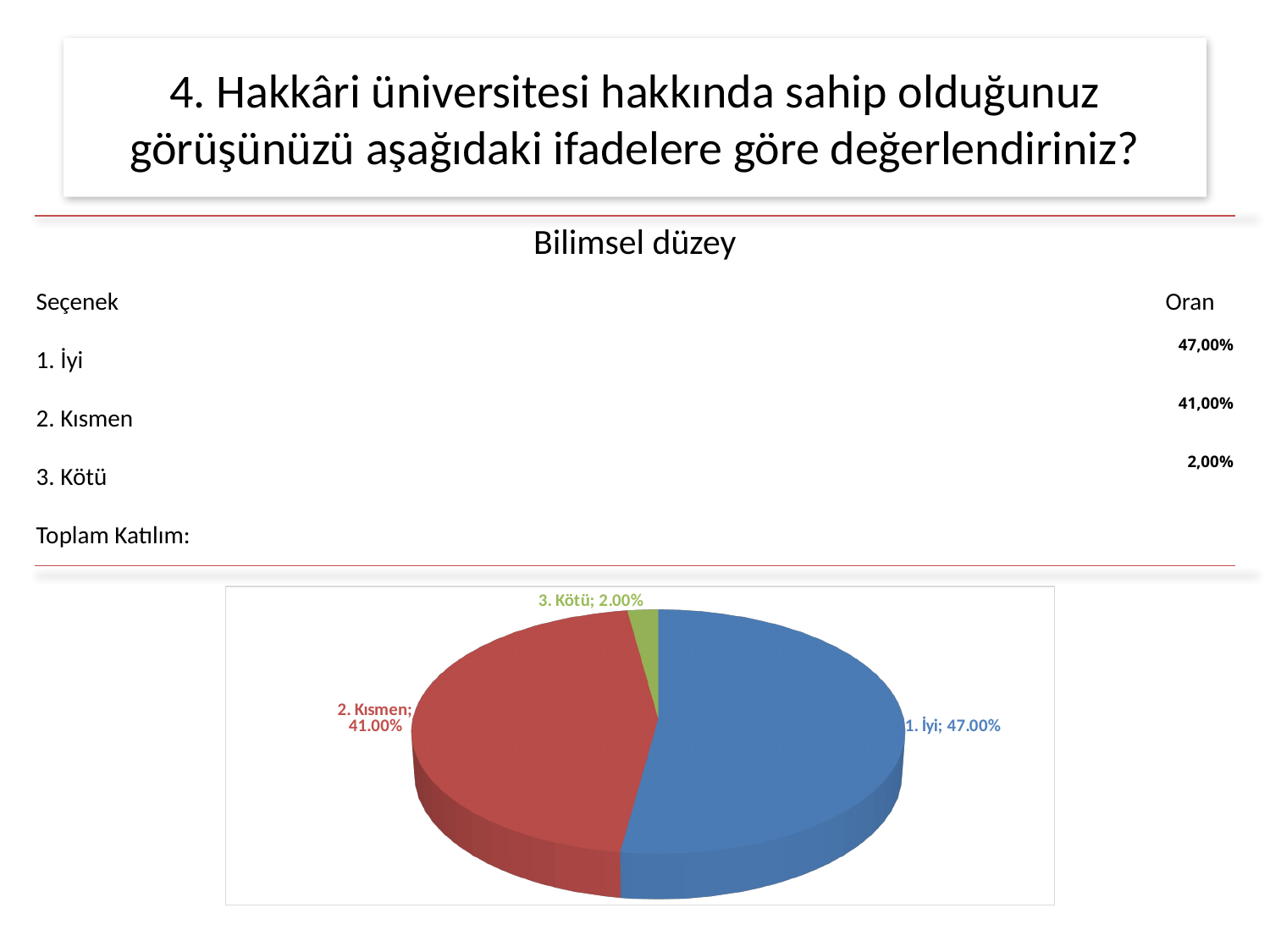
What is the value shown for the slice labelled "1. İyi" in the pie chart? 47.00% What colour is the slice for "3. Kötü" in the pie chart? green What is the value shown for the slice labelled "2. Kısmen" in the pie chart? 41.00% What kind of chart is shown on the slide? pie chart What is the difference between the values for "2. Kısmen" and "3. Kötü" in the pie chart? 39.00% What colour is the slice for "1. İyi" in the pie chart? blue What is the value shown for the slice labelled "3. Kötü" in the pie chart? 2.00% What is the difference between the values for "1. İyi" and "2. Kısmen" in the pie chart? 6.00% Which is larger in the pie chart, the slice for "2. Kısmen" or the slice for "3. Kötü"? 2. Kısmen Which slice of the pie chart is the largest? 1. İyi Which slice of the pie chart is the smallest? 3. Kötü How many slices does the pie chart have? 3